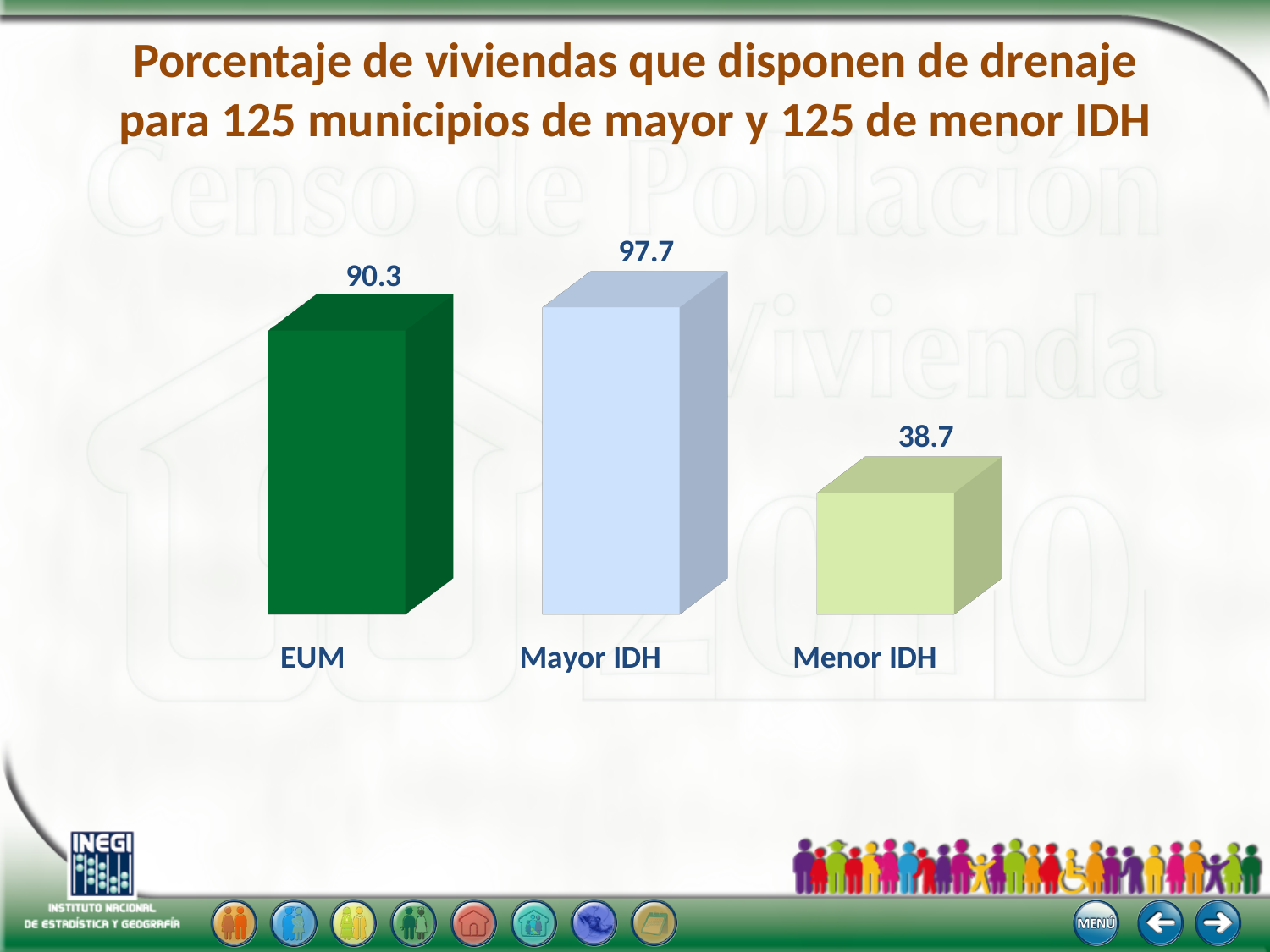
Which category has the lowest value? Menor IDH How many categories are shown in the chart? 3 What is the value for EUM? 90.3 What is the difference between the values for Mayor IDH and Menor IDH? 59.0 What is the value for Menor IDH? 38.7 What is the value for Mayor IDH? 97.7 What colour is the bar for EUM? Dark green What is the title of the chart? Porcentaje de viviendas que disponen de drenaje para 125 municipios de mayor y 125 de menor IDH Which category has the highest value? Mayor IDH Which is larger, the value for EUM or the value for Menor IDH? EUM What kind of chart is shown on the slide? Bar chart What is the difference between the values for Mayor IDH and EUM? 7.4